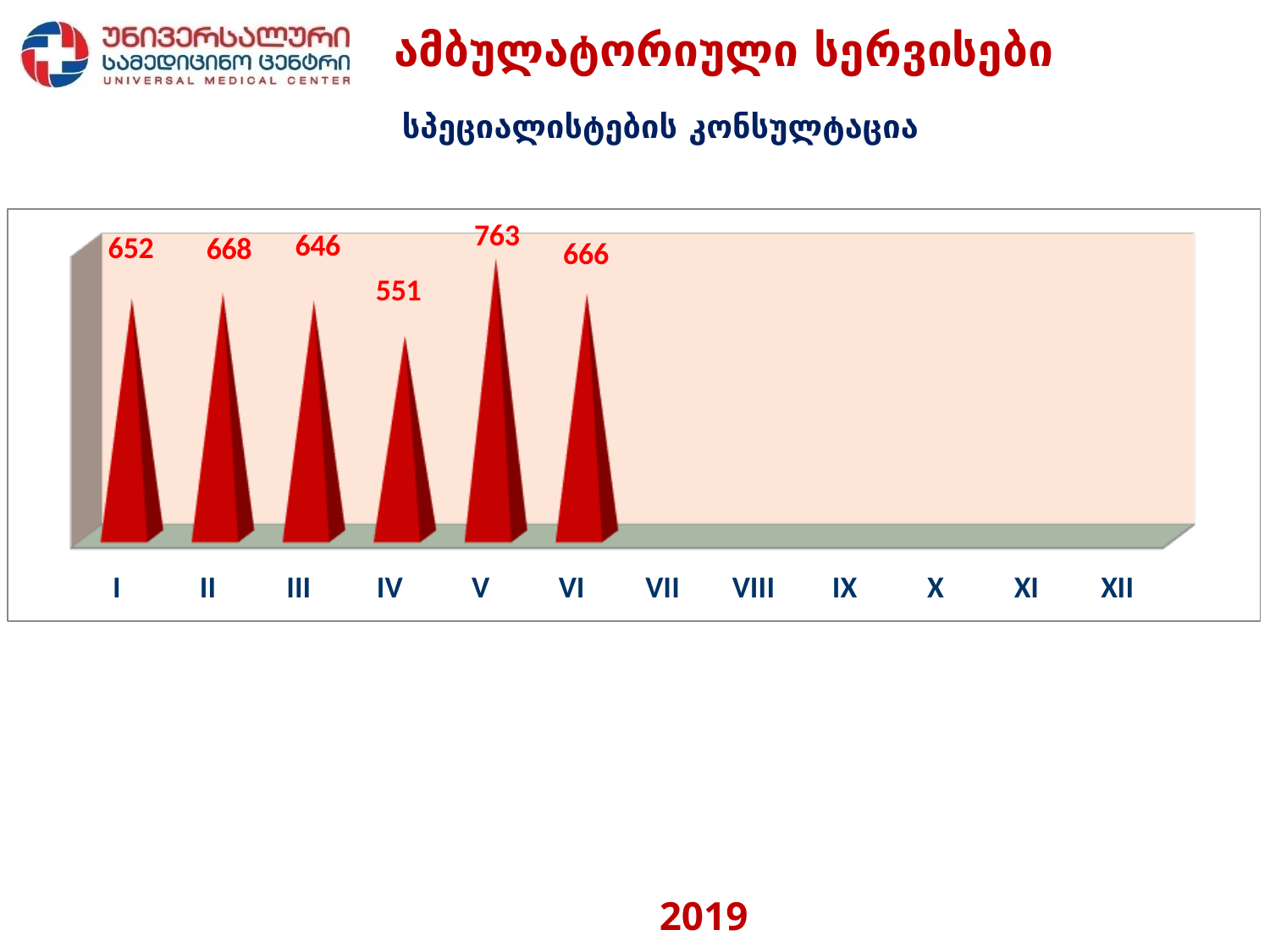
What year is shown at the bottom of the slide? 2019 What is the value for month VI? 666 Which month has the highest value? V How many categories are labelled on the x axis? 12 What is the difference between the values for month V and month IV? 212 How many months on the x axis have a plotted value? 6 Which month has the lowest value among those with data? IV What is the difference between the values for month II and month I? 16 Which is larger, the value for month III or the value for month IV? III What kind of chart is shown on the slide? bar chart What is the value for month I? 652 What is the value for month IV? 551